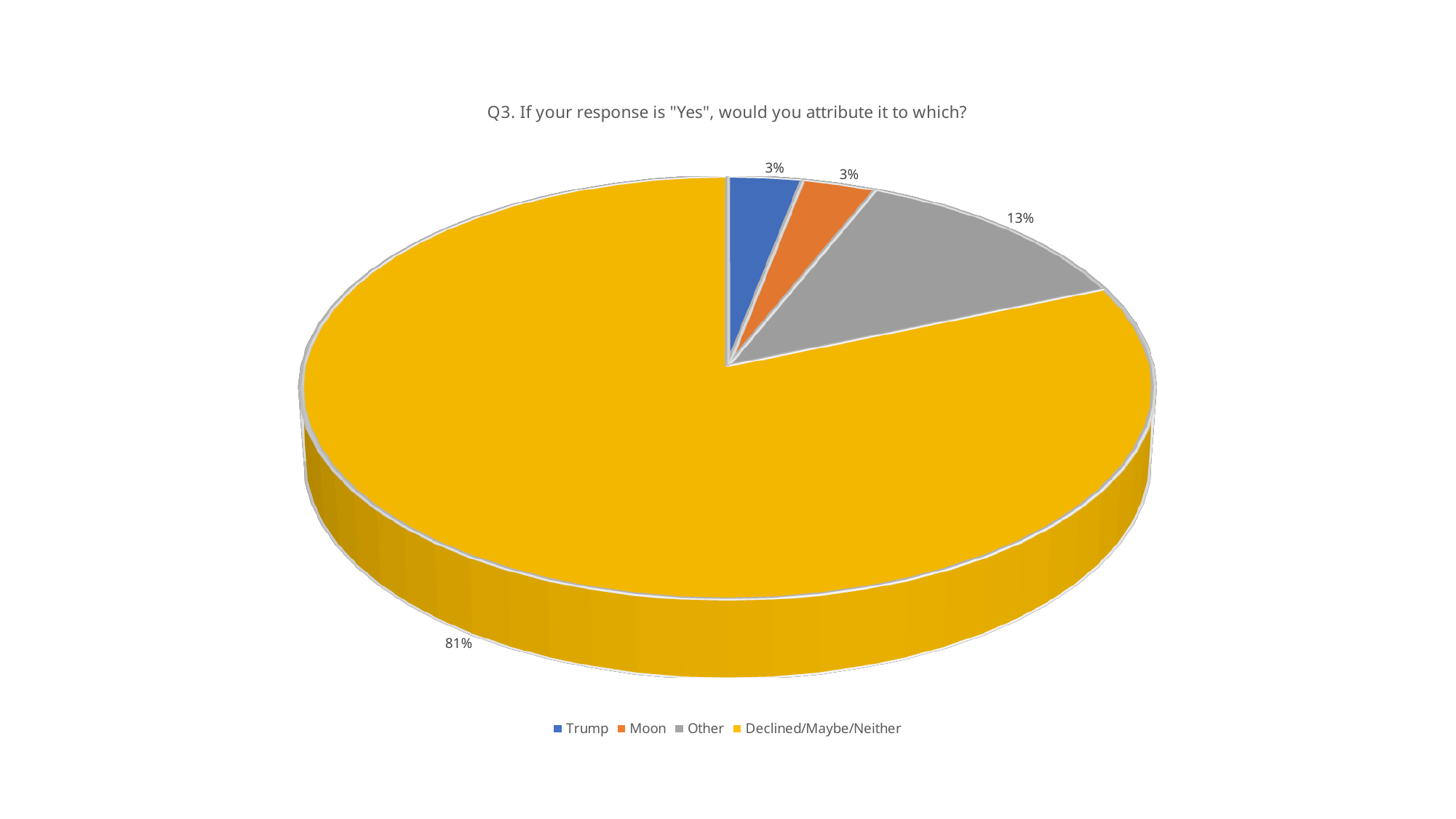
Which colour represents Declined/Maybe/Neither in the legend? Yellow What share of the pie is Moon? 3% How many categories does the legend list? 4 What is the title of the chart? Q3. If your response is "Yes", would you attribute it to which? What share of the pie is Trump? 3% What share of the pie is Declined/Maybe/Neither? 81% Which is larger, the Other slice or the Moon slice? Other Which category has the largest slice? Declined/Maybe/Neither What is the difference between the Declined/Maybe/Neither share and the Other share? 68% What is the difference between the Other share and the Trump share? 10% What kind of chart is shown on the slide? Pie chart